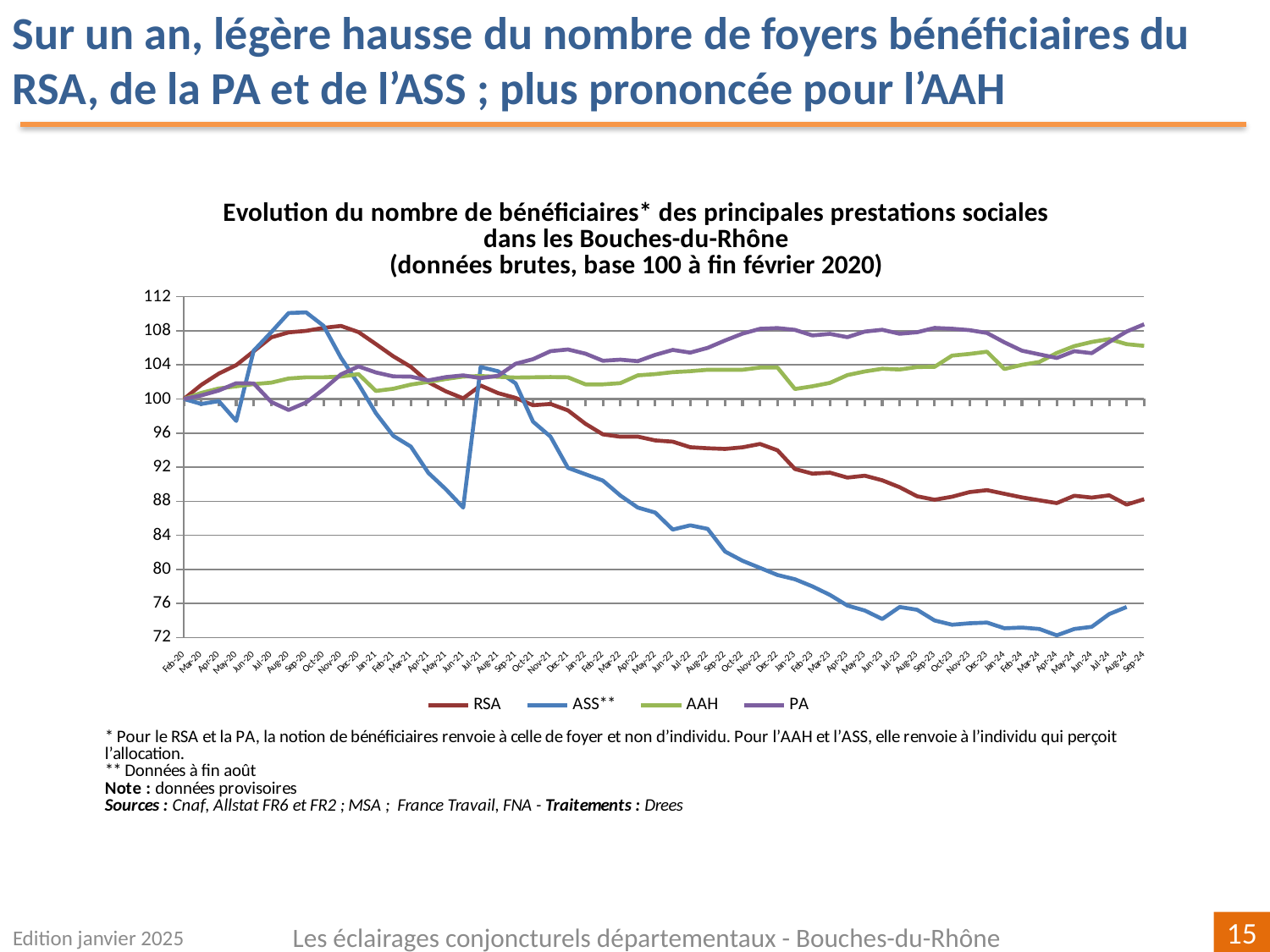
Which series are listed in the legend? RSA, ASS**, AAH, PA How many series does the legend list? 4 Is the value for RSA at Sep-24 greater or less than 92? less Is the value for PA at Sep-24 greater or less than 104? greater Does the AAH series rise or fall overall from Feb-20 to Sep-24? Rise Is the value for ASS** at Sep-20 greater or less than 108? greater What is the value of the series at Feb-20, the base month? 100 What kind of chart is shown on the slide? Line chart Does the ASS** series rise or fall overall from Feb-20 to Sep-24? Fall At Sep-24, which is larger, the value for AAH or the value for RSA? AAH Which series has the lowest value at Sep-24? RSA